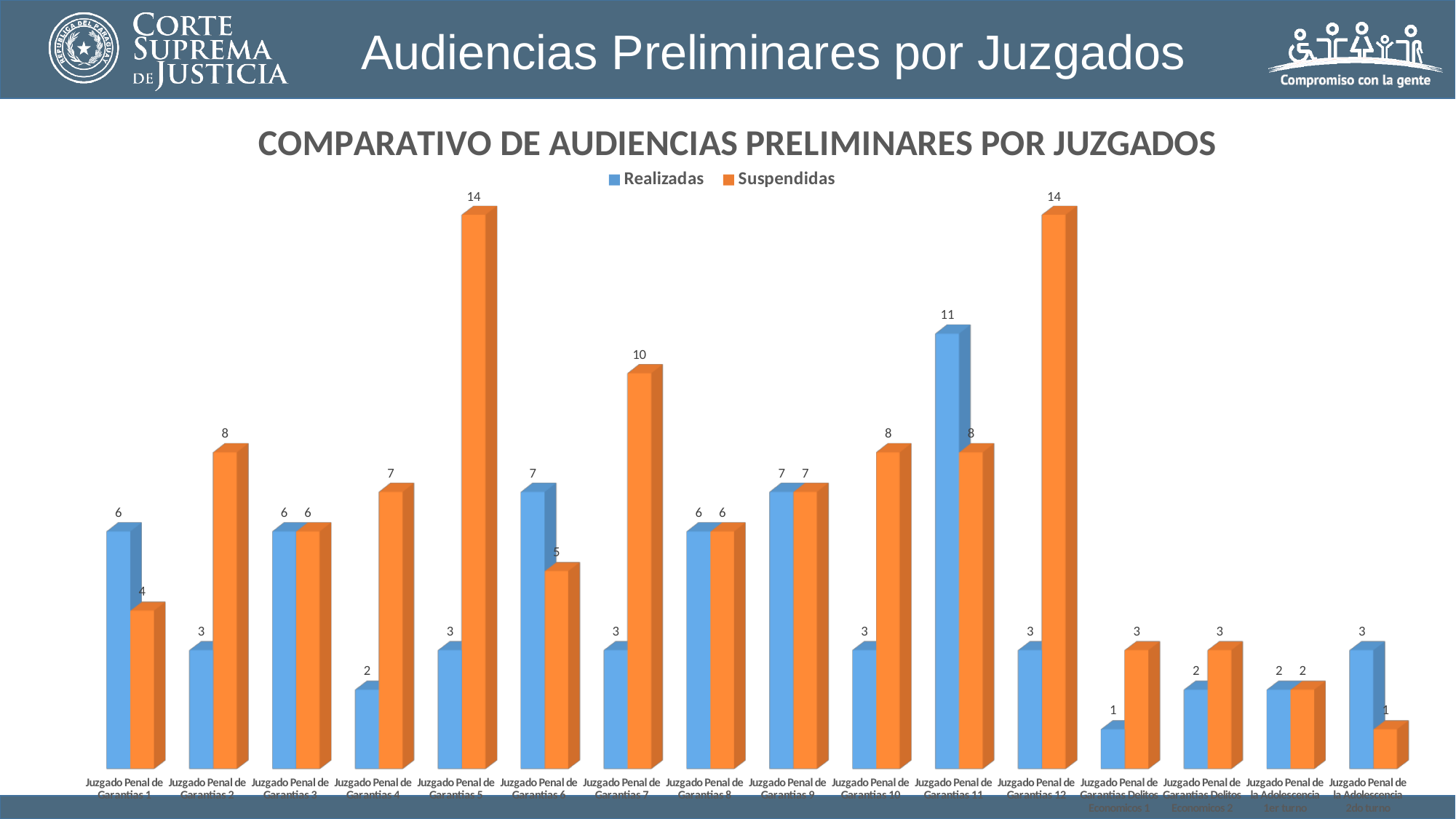
What is the difference between Suspendidas and Realizadas for Juzgado Penal de Garantías 5? 11 What is the Realizadas value for Juzgado Penal de Garantías 11? 11 What is the Suspendidas value for Juzgado Penal de Garantías 1? 4 How many series does the legend list? 2 How many juzgados (categories) are shown on the x axis? 16 Which juzgado has the highest Realizadas value? Juzgado Penal de Garantías 11 What is the title of the chart? COMPARATIVO DE AUDIENCIAS PRELIMINARES POR JUZGADOS Which juzgado has the lowest Realizadas value? Juzgado Penal de Garantías Delitos Económicos 1 Which colour represents the Suspendidas series? orange For Juzgado Penal de Garantías 6, which is larger, Realizadas or Suspendidas? Realizadas What is the Suspendidas value for Juzgado Penal de Garantías 7? 10 What type of chart is shown on the slide? bar chart